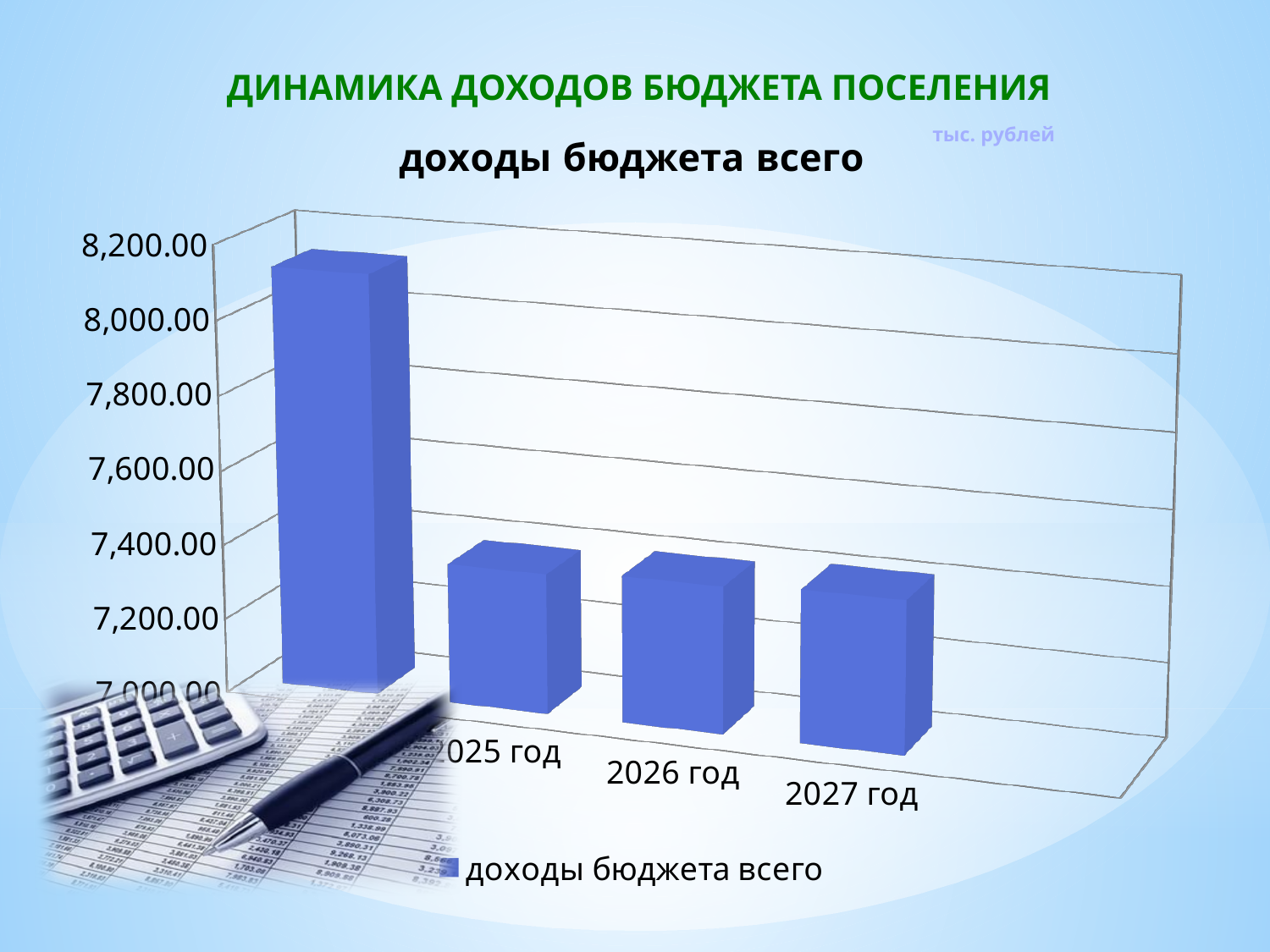
How many series does the legend list? 1 What unit is indicated for the chart values? тыс. рублей What is the title of the chart? доходы бюджета всего Is the value for 2025 год greater or less than 7,200.00? greater Is the value for the first (leftmost) bar greater or less than 8,000.00? greater How many bars are plotted in the chart? 4 Is the value for 2025 год greater or less than 7,400.00? less What kind of chart is shown on the slide? bar chart